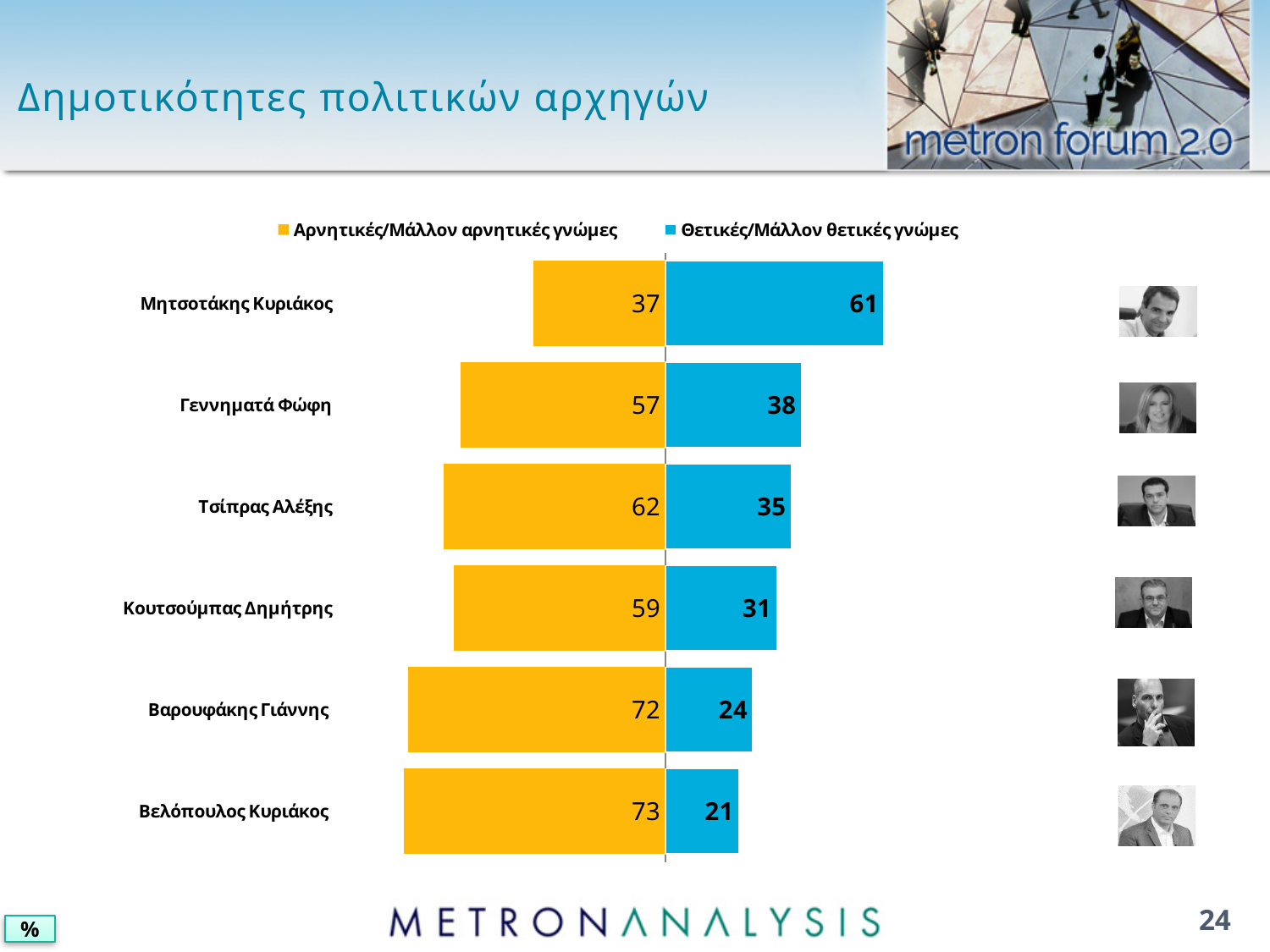
How many politicians are shown in the chart? 6 Which politician has the lowest value for Αρνητικές/Μάλλον αρνητικές γνώμες? Μητσοτάκης Κυριάκος Which politician has the lowest value for Θετικές/Μάλλον θετικές γνώμες? Βελόπουλος Κυριάκος What is the value of Θετικές/Μάλλον θετικές γνώμες for Κουτσούμπας Δημήτρης? 31 What is the value of Αρνητικές/Μάλλον αρνητικές γνώμες for Βαρουφάκης Γιάννης? 72 What colour represents Θετικές/Μάλλον θετικές γνώμες in the chart? Blue How many series does the legend list? 2 Which politician has the highest value for Θετικές/Μάλλον θετικές γνώμες? Μητσοτάκης Κυριάκος What is the value of Θετικές/Μάλλον θετικές γνώμες for Μητσοτάκης Κυριάκος? 61 What is the difference between the Αρνητικές/Μάλλον αρνητικές γνώμες and Θετικές/Μάλλον θετικές γνώμες values for Τσίπρας Αλέξης? 27 What kind of chart is shown on the slide? Bar chart Which is larger: the Θετικές/Μάλλον θετικές γνώμες value for Γεννηματά Φώφη or for Τσίπρας Αλέξης? Γεννηματά Φώφη